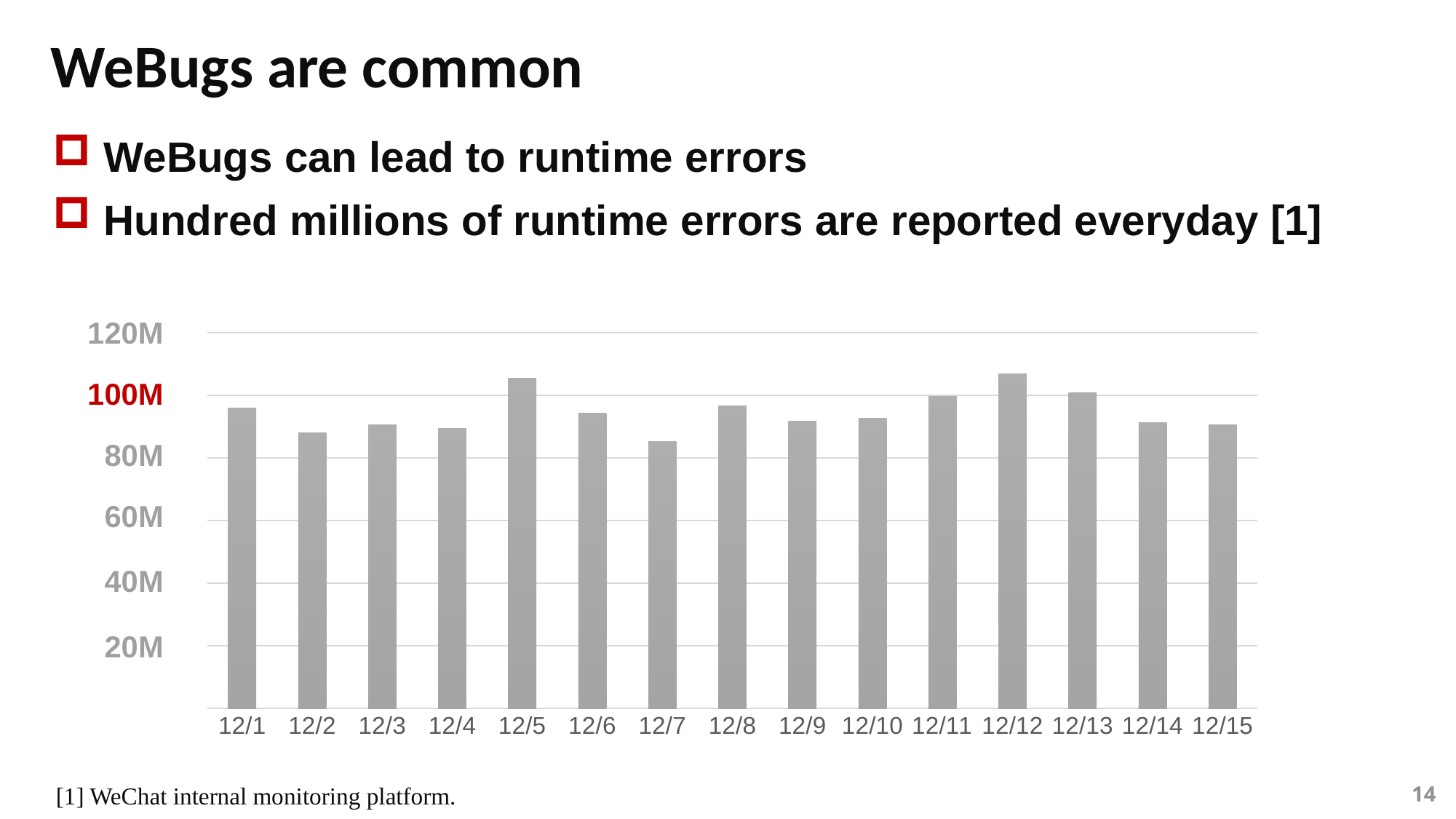
Which is larger, the value for 12/12 or the value for 12/14? 12/12 Is the value for 12/12 greater or less than 100M? greater What kind of chart is shown on the slide? bar chart Is the value for 12/5 greater or less than 100M? greater Which date has the lowest bar in the chart? 12/7 How many dates are shown along the x axis of the chart? 15 Which is larger, the value for 12/2 or the value for 12/8? 12/8 Is the value for 12/7 greater or less than 100M? less Which y-axis tick label is highlighted in red on the chart? 100M Which is larger, the value for 12/5 or the value for 12/7? 12/5